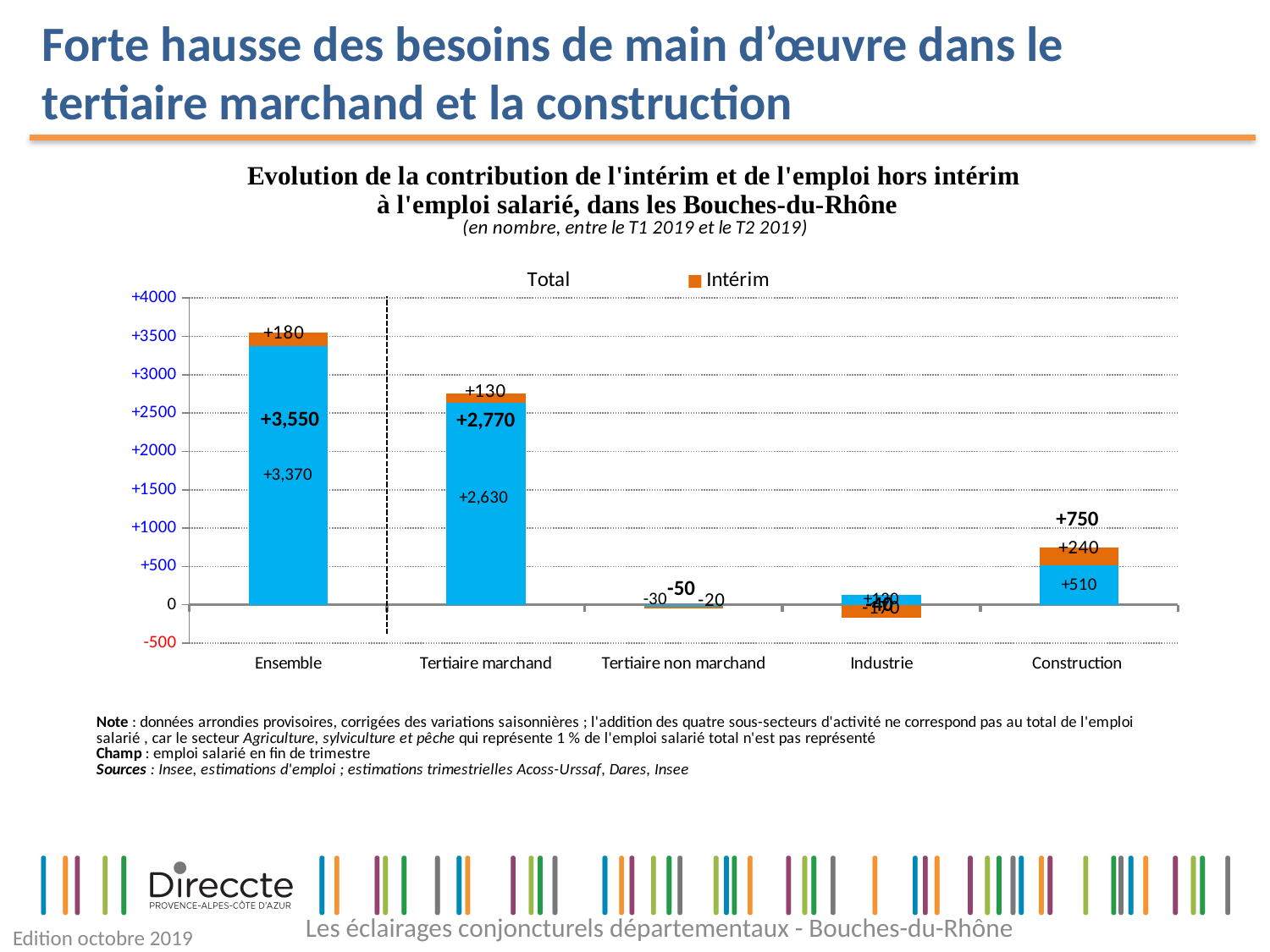
What is the difference between the Intérim values for Construction and Tertiaire marchand? 110 What is the total value shown for Tertiaire non marchand? -50 What is the total value shown for Construction? +750 What kind of chart is this? Stacked bar chart What is the total value shown for Ensemble? +3,550 What is the Intérim value for Tertiaire marchand? +130 Which is larger, the Intérim value for Ensemble or the Intérim value for Construction? Intérim value for Construction How many series does the legend list? 2 Which category has the lowest total value? Tertiaire non marchand Which category has the highest total value? Ensemble What is the Intérim value for Construction? +240 How many categories are shown on the x axis? 5